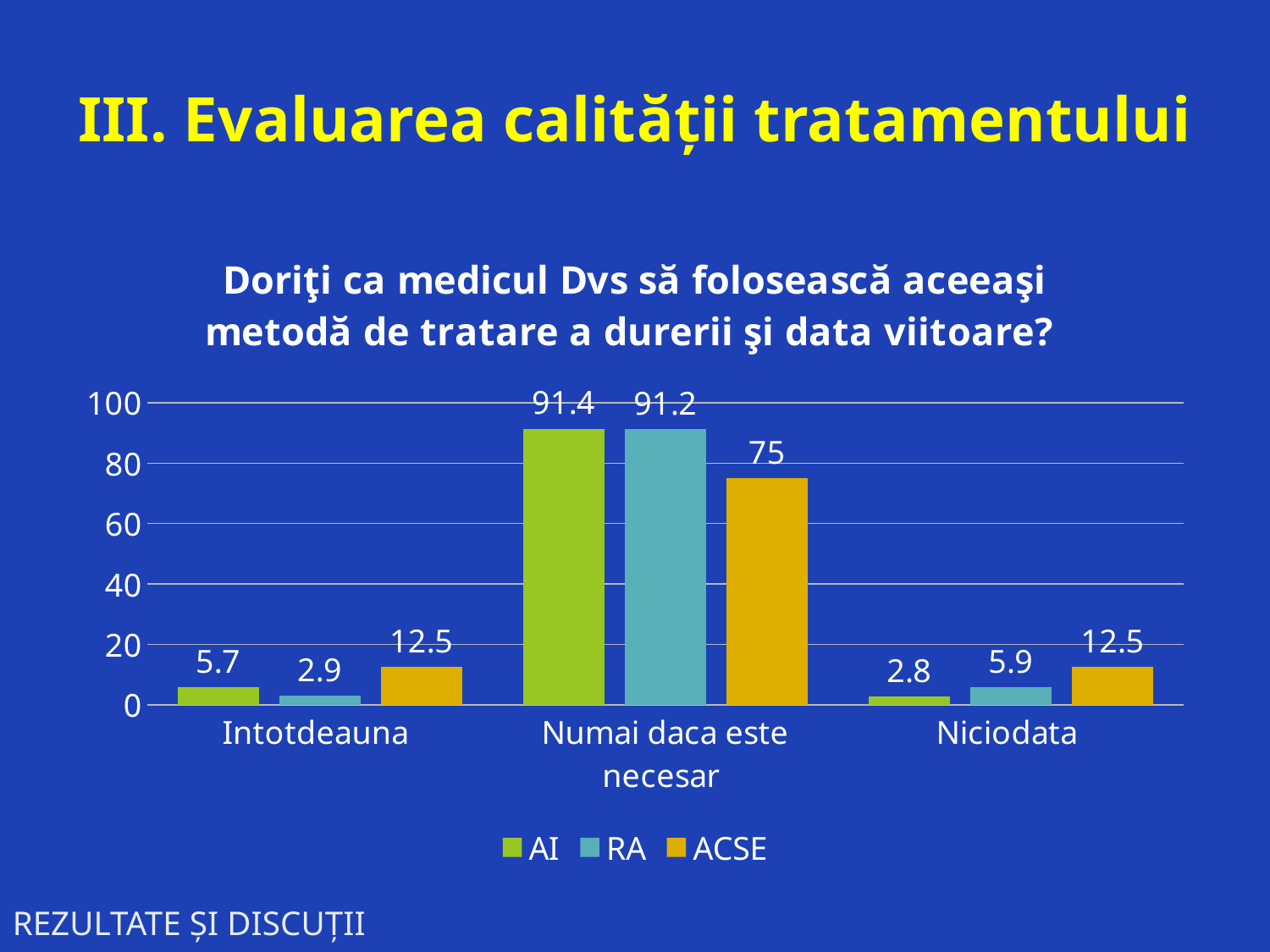
Is the value for RA in the 'Numai daca este necesar' category greater or less than 80? greater What kind of chart is shown on the slide? Bar chart Which category has the highest value for the ACSE series? Numai daca este necesar Which series is shown in yellow/orange in the legend? ACSE What is the difference between the AI and ACSE values in the 'Numai daca este necesar' category? 16.4 How many series does the legend list? 3 How many categories are shown on the x axis? 3 What is the value for AI in the 'Numai daca este necesar' category? 91.4 Which category has the lowest value for the AI series? Niciodata In the 'Intotdeauna' category, which series has the larger value, AI or RA? AI What is the value for ACSE in the 'Intotdeauna' category? 12.5 What is the value for RA in the 'Niciodata' category? 5.9